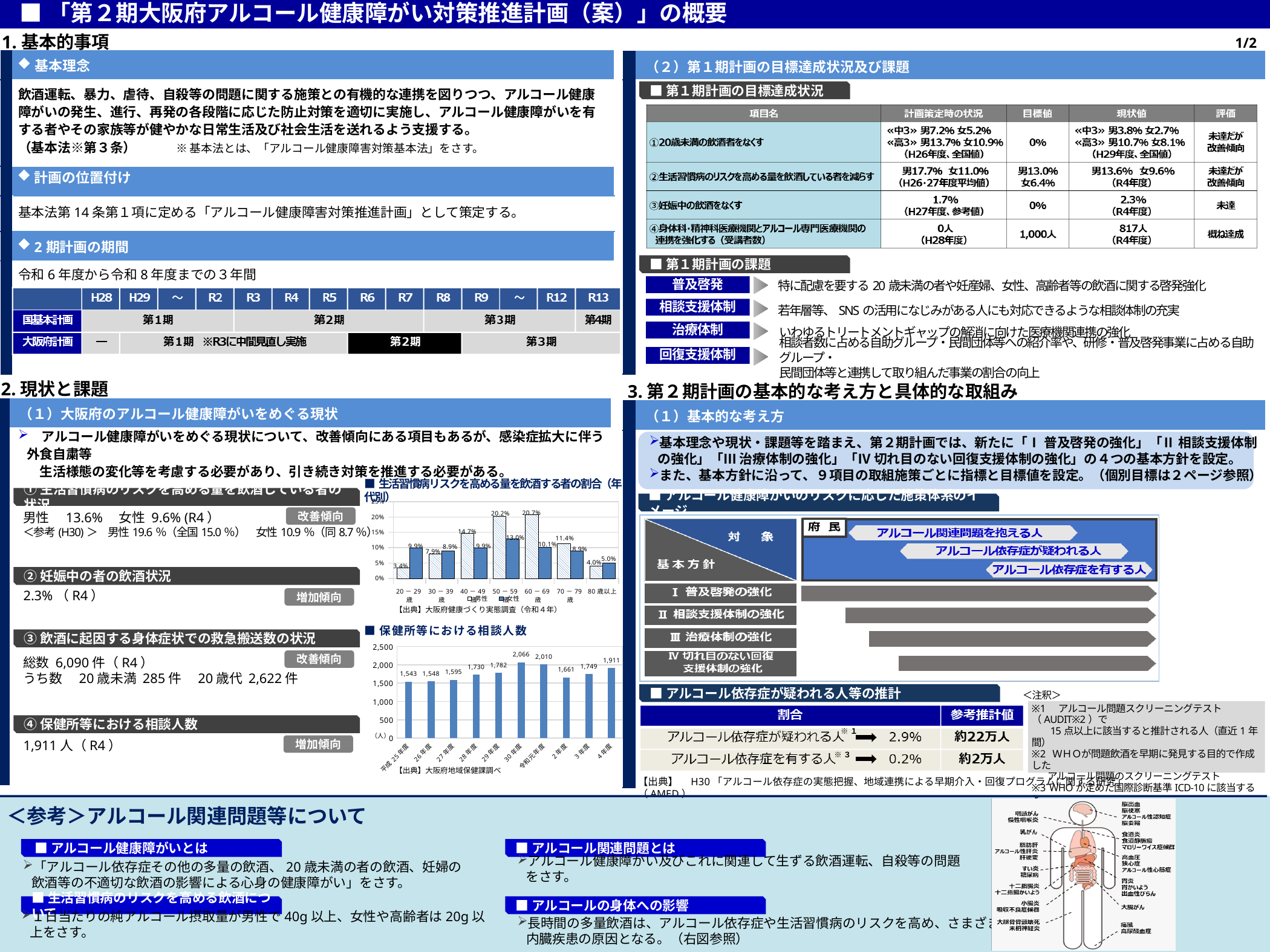
In the chart titled 生活習慣病リスクを高める量を飲酒する者の割合（年代別）, what is the value for 男性 in the 60－69歳 group? 20.7% In the chart titled 保健所等における相談人数, which year has the lowest value? 平成25年度 In the chart titled 保健所等における相談人数, what is the value for 平成25年度? 1,543 In the chart titled 保健所等における相談人数, which year has the highest value? 30年度 In the chart titled 保健所等における相談人数, what kind of chart is it? bar chart In the chart titled 生活習慣病リスクを高める量を飲酒する者の割合（年代別）, which is larger in the 20－29歳 group, 男性 or 女性? 女性 In the chart titled 生活習慣病リスクを高める量を飲酒する者の割合（年代別）, what is the value for 女性 in the 50－59歳 group? 13.0% In the chart titled 生活習慣病リスクを高める量を飲酒する者の割合（年代別）, what is the difference between 男性 and 女性 in the 40－49歳 group? 4.8% In the chart titled 保健所等における相談人数, what is the difference between the values for 30年度 and 令和元年度? 56 In the chart titled 生活習慣病リスクを高める量を飲酒する者の割合（年代別）, how many series does the legend list? 2 In the chart titled 保健所等における相談人数, what is the value for 令和4年度? 1,911 In the chart titled 保健所等における相談人数, how many years are plotted? 10